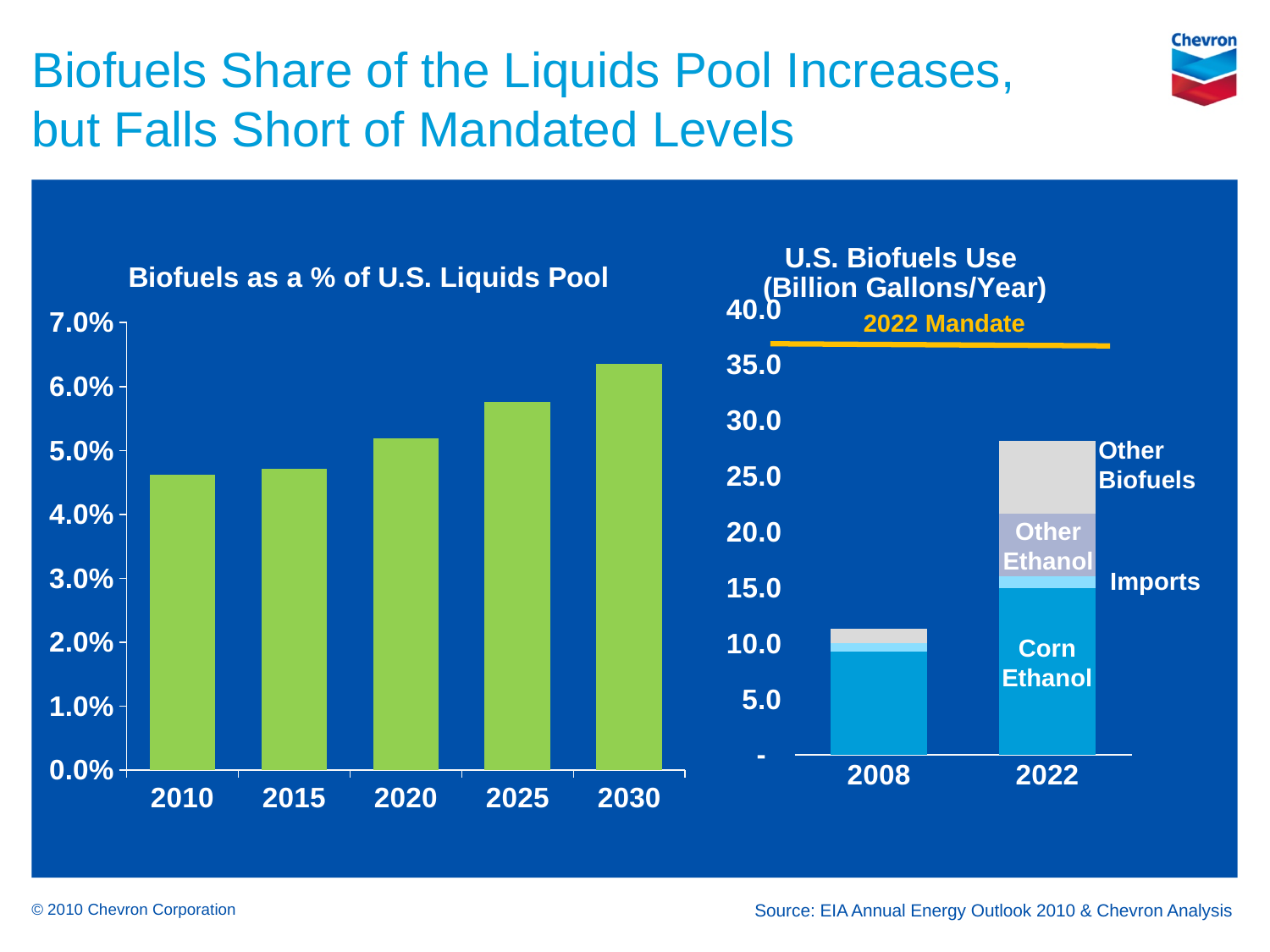
In the "Biofuels as a % of U.S. Liquids Pool" chart, which year has the highest value? 2030 In the "U.S. Biofuels Use (Billion Gallons/Year)" chart, is the total for 2008 greater or less than 15.0? less In the "U.S. Biofuels Use (Billion Gallons/Year)" chart, what does the yellow horizontal line represent? 2022 Mandate In the "Biofuels as a % of U.S. Liquids Pool" chart, is the value for 2030 greater or less than 6.0%? greater In the "Biofuels as a % of U.S. Liquids Pool" chart, do the values rise or fall from 2010 to 2030? rise In the "U.S. Biofuels Use (Billion Gallons/Year)" chart, which year has the taller stacked bar, 2008 or 2022? 2022 In the "Biofuels as a % of U.S. Liquids Pool" chart, is the value for 2010 greater or less than 5.0%? less In the "Biofuels as a % of U.S. Liquids Pool" chart, how many years are shown on the x axis? 5 In the "Biofuels as a % of U.S. Liquids Pool" chart, which year has the lowest value? 2010 What kind of chart is "Biofuels as a % of U.S. Liquids Pool"? bar chart In the "Biofuels as a % of U.S. Liquids Pool" chart, which is larger, the value for 2020 or the value for 2025? 2025